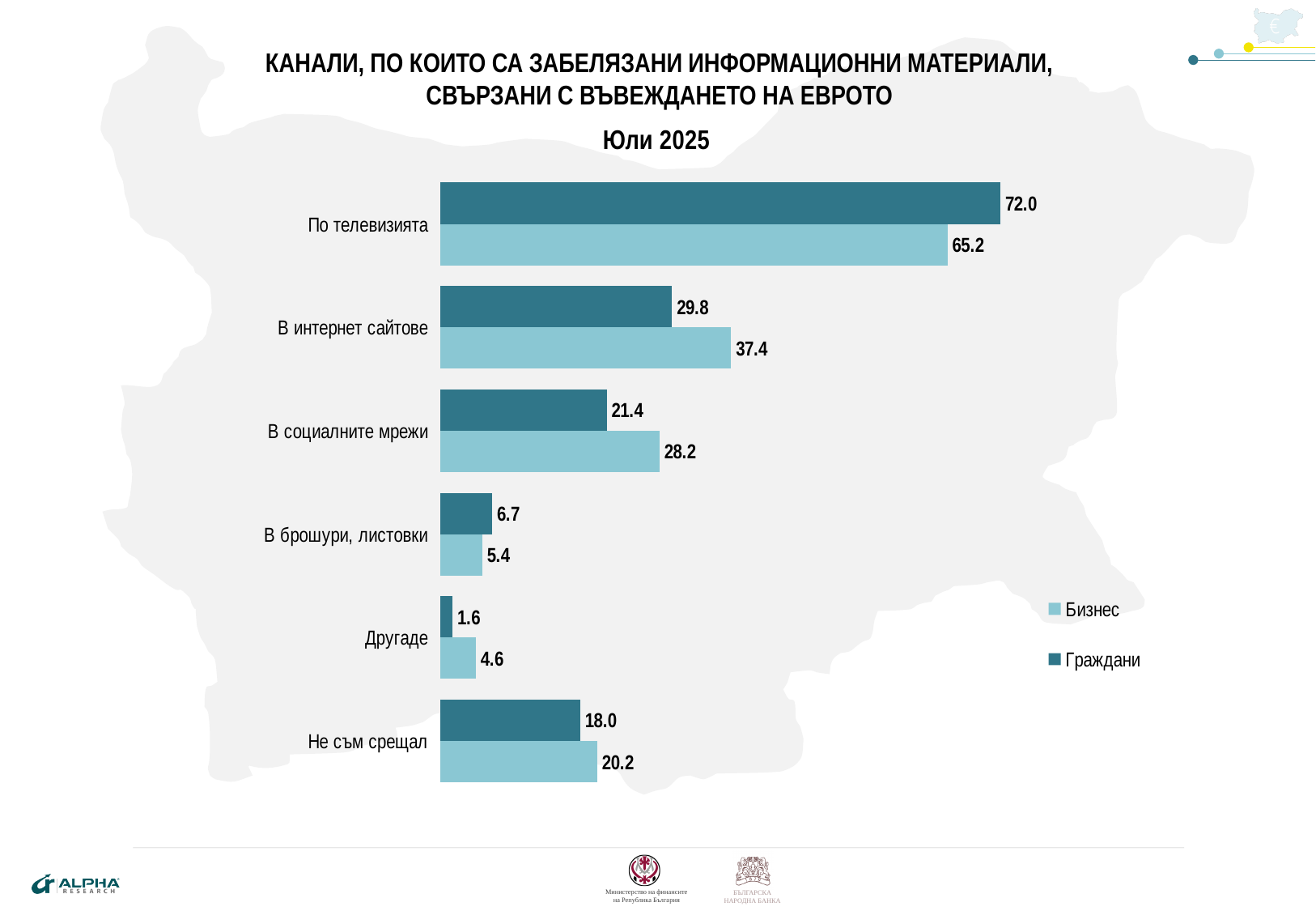
What is the difference between the Граждани and Бизнес values for По телевизията? 6.8 What is the value for Бизнес for Другаде? 4.6 What is the value for Граждани for По телевизията? 72.0 Which category has the highest value for Бизнес? По телевизията For В брошури, листовки, which is larger: the Бизнес value or the Граждани value? Граждани What is the value for Граждани for Не съм срещал? 18.0 Which category has the lowest value for Граждани? Другаде What kind of chart is shown on the slide? Bar chart What is the difference between the Бизнес and Граждани values for В социалните мрежи? 6.8 What is the value for Бизнес for В интернет сайтове? 37.4 How many categories are shown on the chart? 6 How many series does the legend list? 2